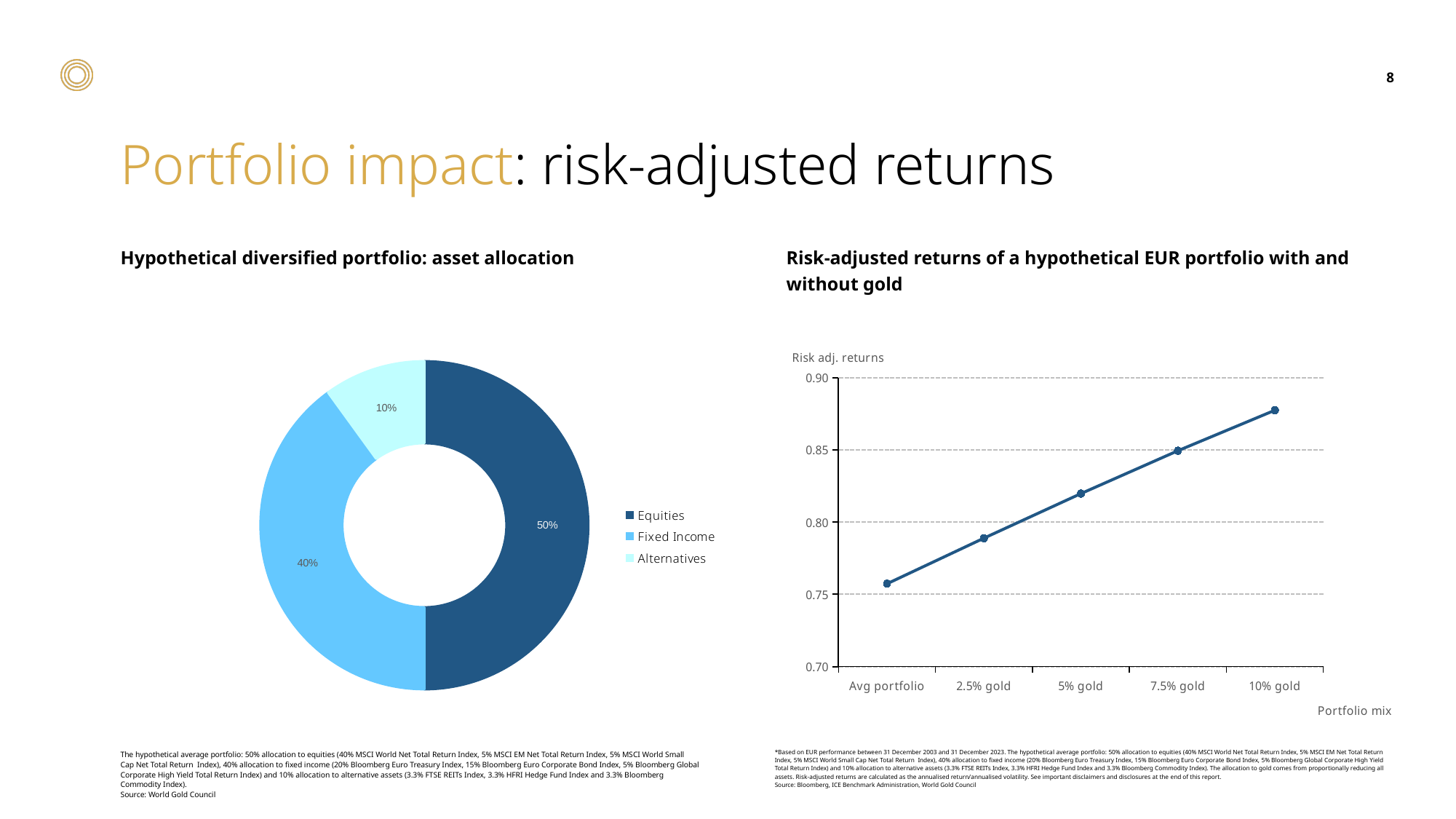
In the 'Risk-adjusted returns of a hypothetical EUR portfolio with and without gold' chart, how many portfolio mixes are plotted on the x axis? 5 In the 'Hypothetical diversified portfolio: asset allocation' chart, what share of the portfolio is allocated to Equities? 50% In the 'Hypothetical diversified portfolio: asset allocation' chart, how many asset classes are shown? 3 In the 'Hypothetical diversified portfolio: asset allocation' chart, what share is allocated to Fixed Income? 40% In the 'Hypothetical diversified portfolio: asset allocation' chart, which asset class has the largest allocation? Equities In the 'Hypothetical diversified portfolio: asset allocation' chart, what share is allocated to Alternatives? 10% In the 'Hypothetical diversified portfolio: asset allocation' chart, which asset class has the smallest allocation? Alternatives In the 'Risk-adjusted returns of a hypothetical EUR portfolio with and without gold' chart, is the value for 10% gold greater or less than 0.85? greater What kind of chart is the 'Hypothetical diversified portfolio: asset allocation' chart? Pie (donut) chart In the 'Risk-adjusted returns of a hypothetical EUR portfolio with and without gold' chart, is the value for Avg portfolio greater or less than 0.80? less In the 'Risk-adjusted returns of a hypothetical EUR portfolio with and without gold' chart, do risk-adjusted returns rise or fall as the gold allocation increases from Avg portfolio to 10% gold? rise In the 'Hypothetical diversified portfolio: asset allocation' chart, how many percentage points larger is the Equities allocation than the Fixed Income allocation? 10 percentage points